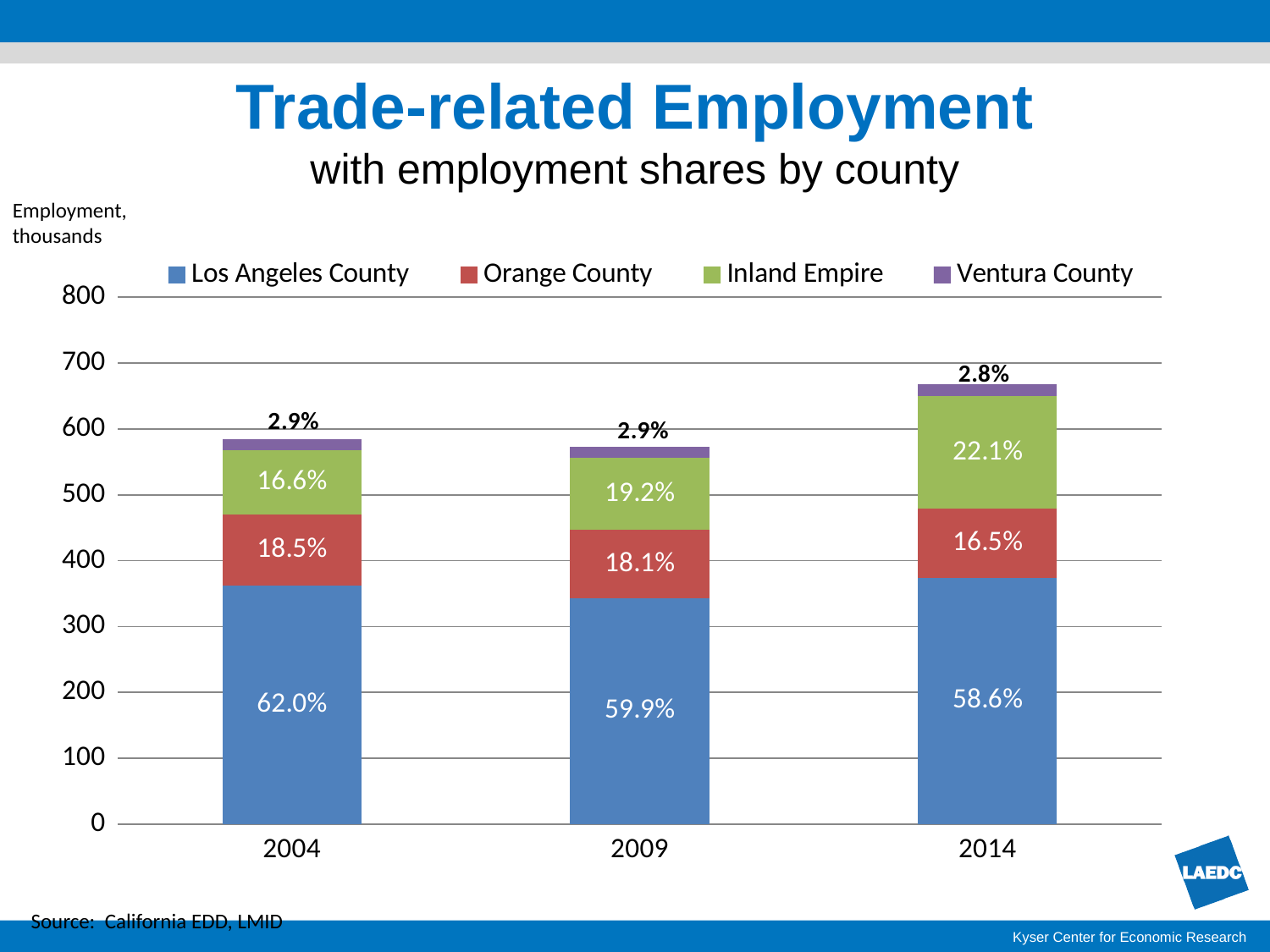
What kind of chart is shown on the slide? Stacked bar chart Which year has the tallest bar (highest total trade-related employment)? 2014 Does the Los Angeles County employment share rise or fall from 2004 to 2014? Fall How many years are shown on the x axis? 3 How many series does the legend list? 4 Is the total employment bar for 2014 greater or less than 600 thousand? greater What is the Orange County employment share in 2009? 18.1% Is the total employment bar for 2009 greater or less than 600 thousand? less What is the Ventura County employment share in 2014? 2.8% What is the Los Angeles County employment share in 2004? 62.0% By how many percentage points did the Inland Empire share change between 2004 and 2014? 5.5 percentage points What is the Inland Empire employment share in 2014? 22.1%